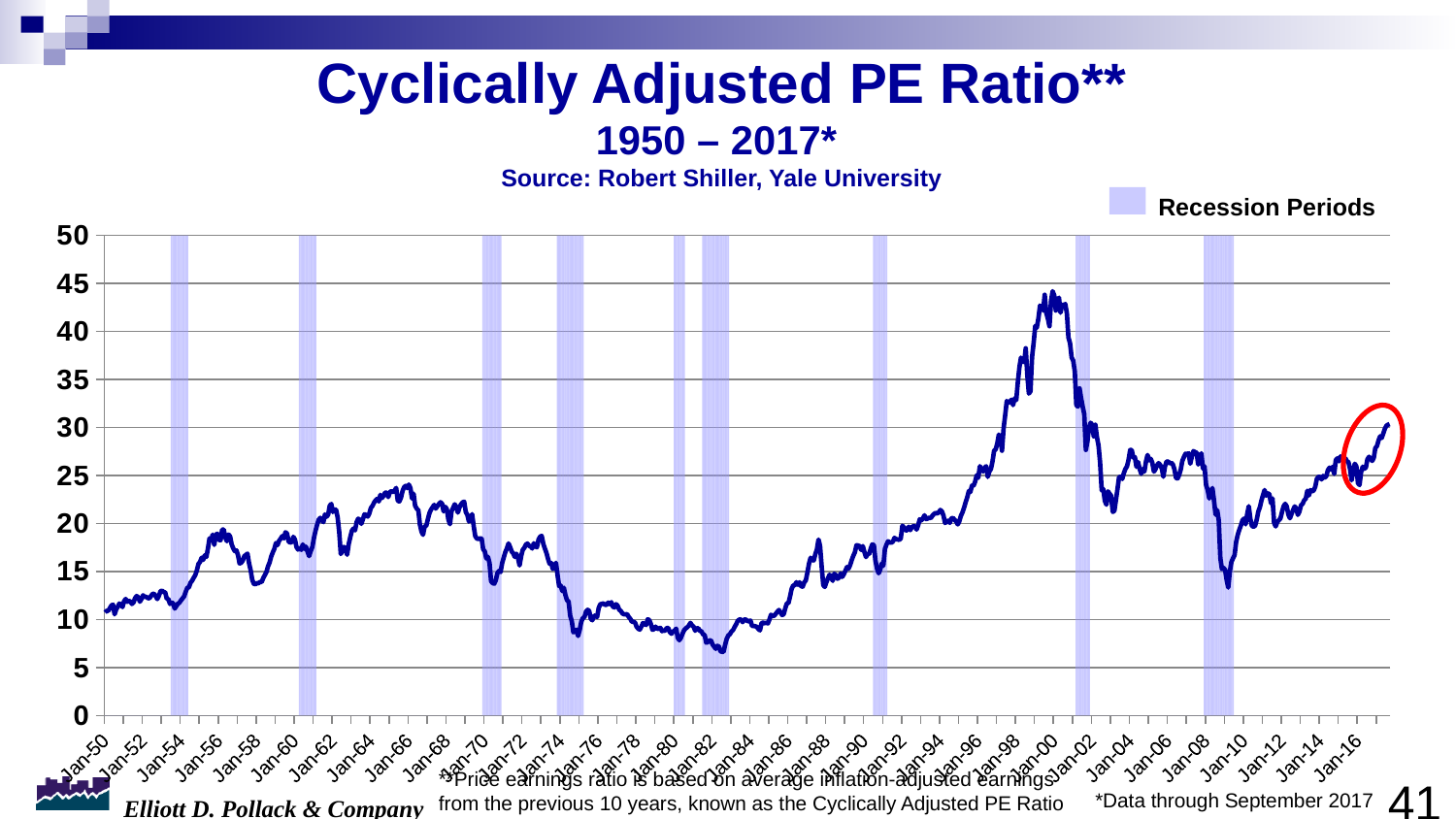
What is the title of the chart? Cyclically Adjusted PE Ratio** Is the peak value of the PE ratio around Jan-00 greater or less than 40? greater Around which year does the Cyclically Adjusted PE Ratio reach its lowest point? Jan-82 Is the value of the PE ratio around Jan-82 greater or less than 10? less Which is larger, the PE ratio around Jan-00 or around Jan-08? Jan-00 Is the value of the PE ratio at Jan-50 greater or less than 15? less Does the PE ratio generally rise or fall between Jan-94 and Jan-00? rise What do the shaded vertical bands on the chart represent, according to the legend? Recession Periods Around which year does the Cyclically Adjusted PE Ratio reach its highest point? Jan-00 What kind of chart is shown on the slide? line chart How many recession periods are shaded on the chart? 9